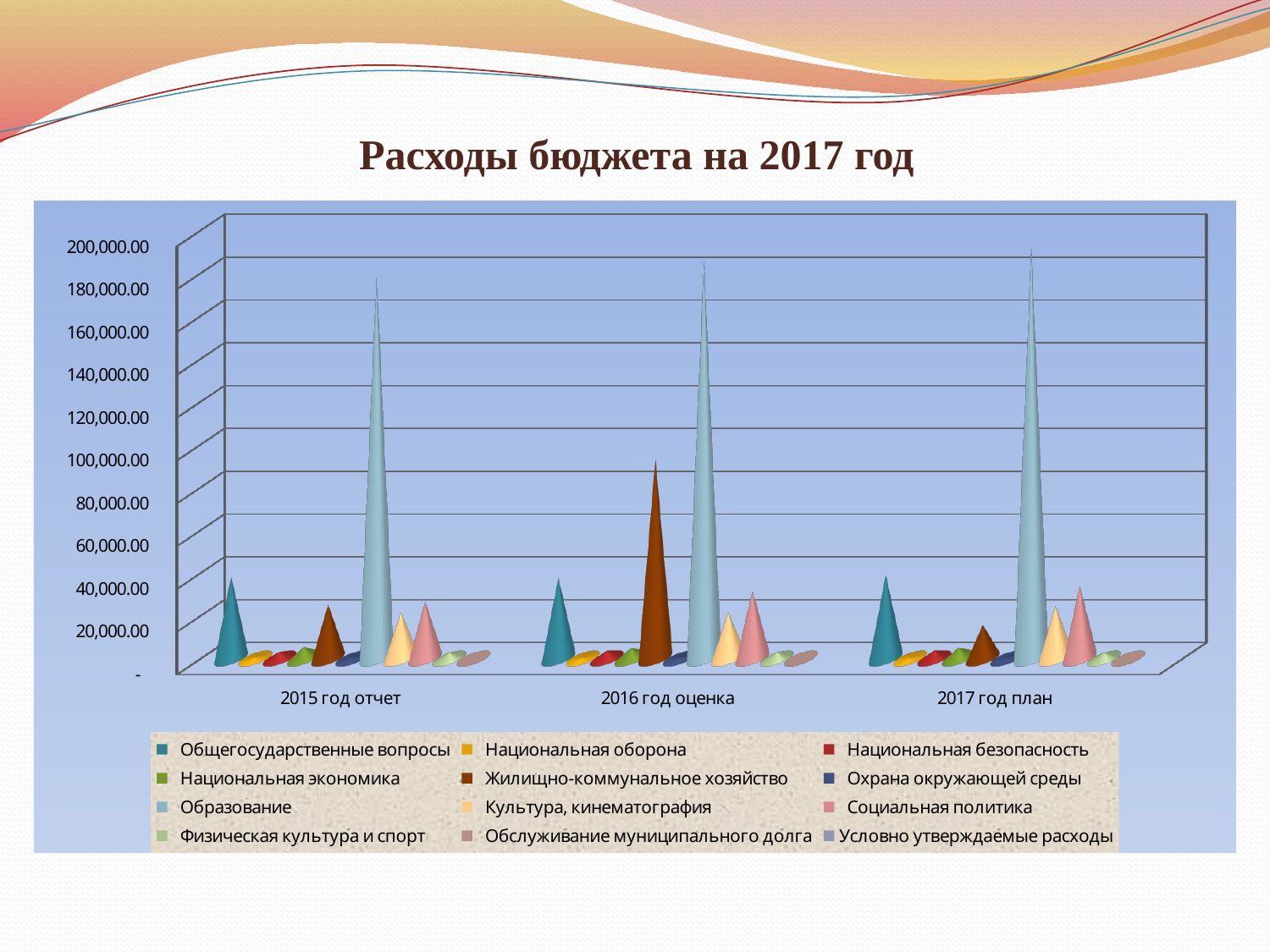
Is the value for Жилищно-коммунальное хозяйство in 2016 год оценка greater or less than 80,000.00? greater How many series does the legend list? 12 Which series has the highest value in the 2017 год план category? Образование Which is larger: Жилищно-коммунальное хозяйство in 2016 год оценка or in 2015 год отчет? 2016 год оценка Is the value for Общегосударственные вопросы in 2017 год план greater or less than 60,000.00? less Does the value for Образование rise or fall from 2015 год отчет to 2017 год план? rises What is the title of the slide's chart? Расходы бюджета на 2017 год Which series has the highest value in the 2016 год оценка category? Образование How many categories are shown along the x axis? 3 What kind of chart is shown on the slide? bar chart Which is larger in 2016 год оценка: Образование or Жилищно-коммунальное хозяйство? Образование Is the value for Образование in 2015 год отчет greater or less than 160,000.00? greater